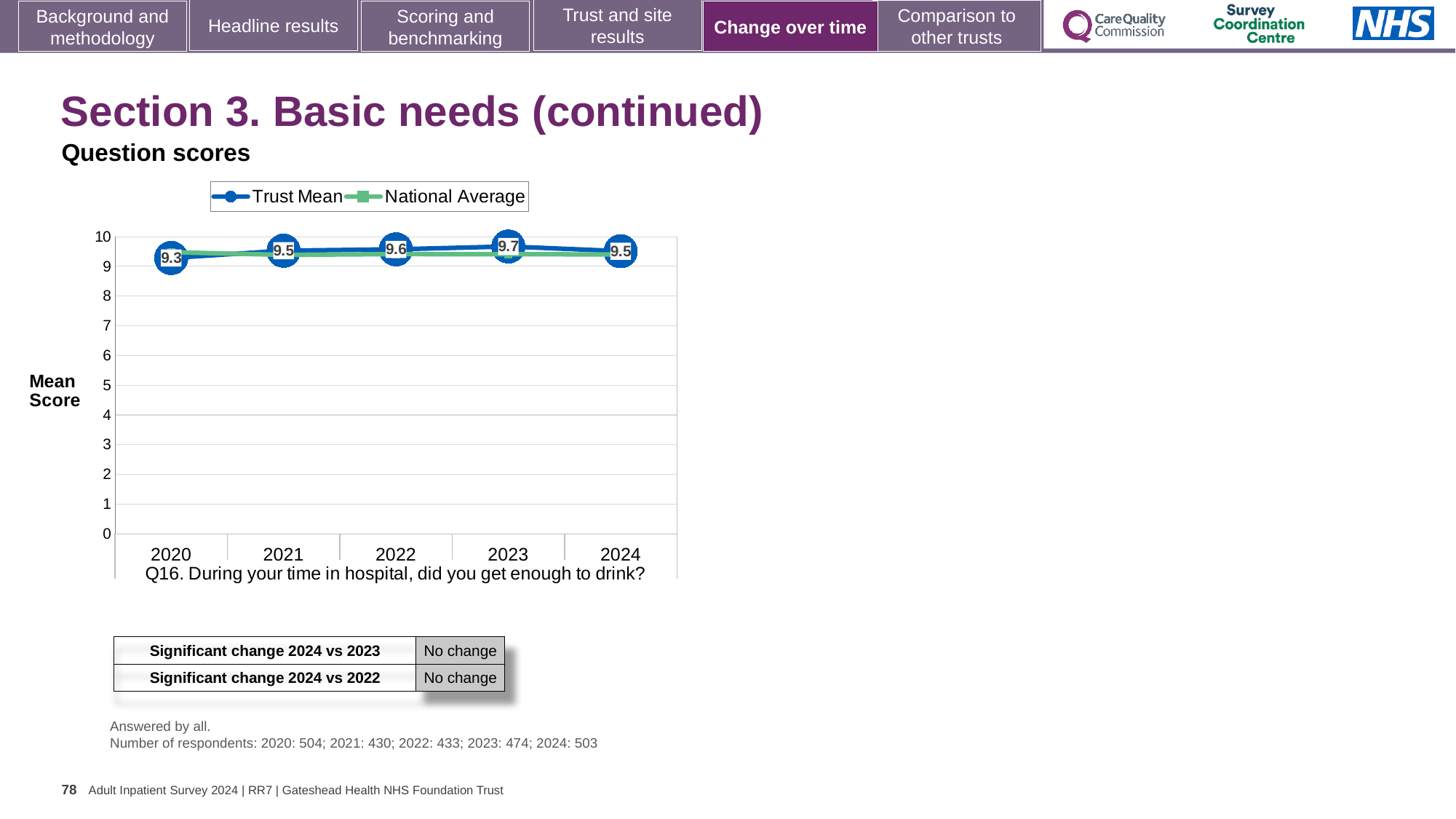
What is the difference between the Trust Mean score in 2023 and in 2020? 0.4 Is the National Average value for 2020 greater or less than 9? greater What kind of chart is shown on the slide? Line chart What is the Trust Mean score for 2020? 9.3 Which year has the higher Trust Mean score, 2020 or 2022? 2022 In which year is the Trust Mean score highest? 2023 What is the label on the y axis of the chart? Mean Score What is the Trust Mean score for 2024? 9.5 How many years are plotted on the x axis? 5 In which year is the Trust Mean score lowest? 2020 What is the Trust Mean score for 2023? 9.7 How many series does the legend list? 2